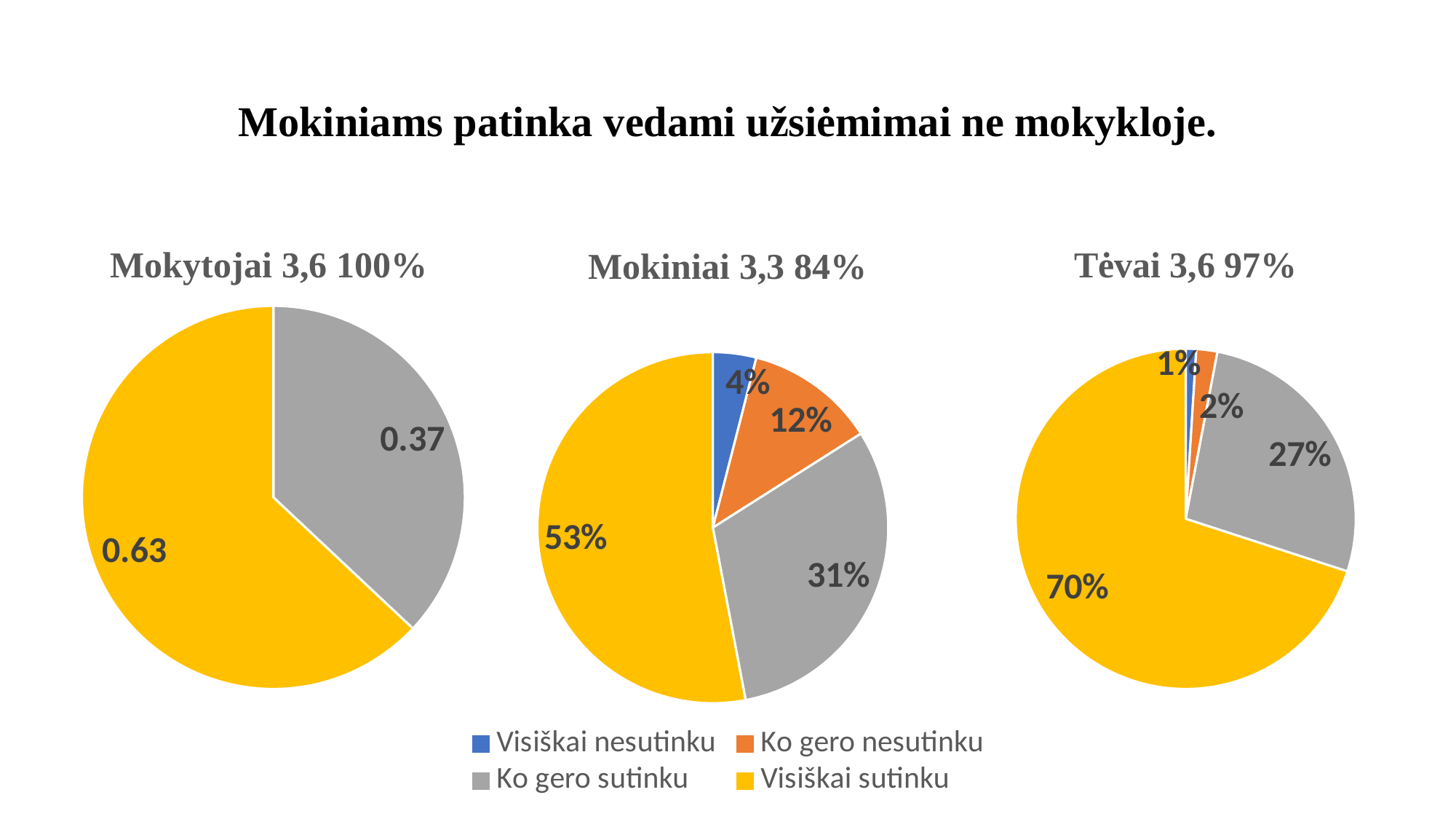
In the "Mokiniai 3,3 84%" chart, which category has the smallest slice? Visiškai nesutinku How many slices does the "Mokiniai 3,3 84%" chart have? 4 What kind of chart is the "Tėvai 3,6 97%" chart? Pie chart Which is larger: "Visiškai sutinku" in the "Tėvai 3,6 97%" chart or "Visiškai sutinku" in the "Mokiniai 3,3 84%" chart? Tėvai 3,6 97% In the "Mokiniai 3,3 84%" chart, what is the difference between "Visiškai sutinku" and "Ko gero sutinku"? 22% In the "Tėvai 3,6 97%" chart, what share is "Ko gero sutinku"? 27% In the "Tėvai 3,6 97%" chart, which category has the largest slice? Visiškai sutinku In the "Mokiniai 3,3 84%" chart, what share is "Ko gero nesutinku"? 12% How many entries does the legend list? 4 In the "Mokiniai 3,3 84%" chart, what share is "Visiškai sutinku"? 53% In the "Mokytojai 3,6 100%" chart, what is the value for "Visiškai sutinku"? 0.63 In the "Mokytojai 3,6 100%" chart, what is the value for "Ko gero sutinku"? 0.37